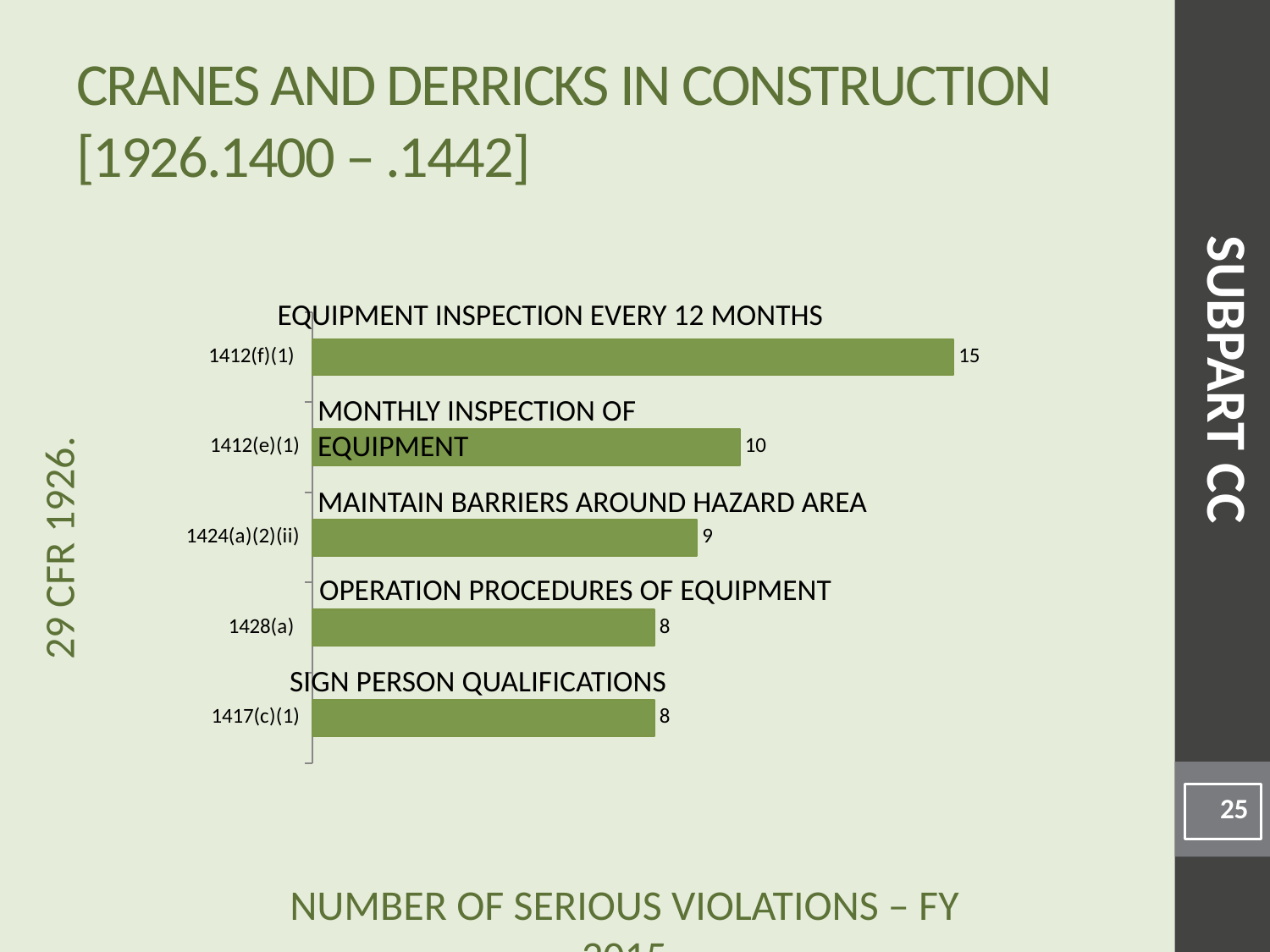
What kind of chart is shown on the slide? Bar chart What is the value for 1424(a)(2)(ii)? 9 Which is larger, the value for 1412(e)(1) or the value for 1428(a)? 1412(e)(1) What is the difference between the values for 1412(f)(1) and 1412(e)(1)? 5 What is the total of all the values shown in the chart? 50 What is the value for 1412(e)(1)? 10 How many categories are shown in the chart? 5 Which category has the highest value? 1412(f)(1) What text label is shown above the bar for 1412(f)(1)? EQUIPMENT INSPECTION EVERY 12 MONTHS What is the value for 1428(a)? 8 What is the difference between the values for 1412(e)(1) and 1424(a)(2)(ii)? 1 What is the value for 1412(f)(1)? 15